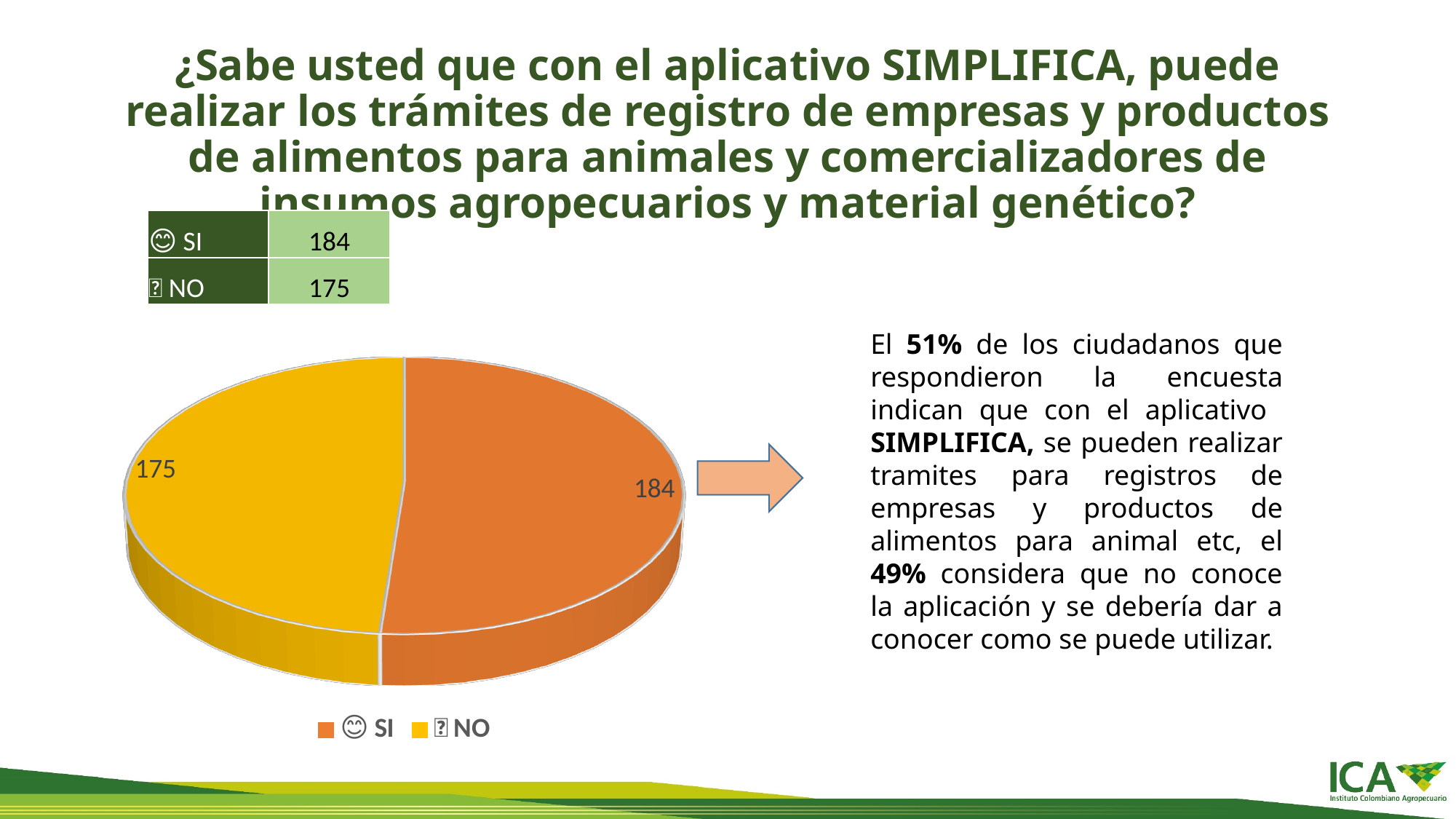
How many slices does the pie chart have? 2 What is the total of all slices in the pie chart? 359 What is the difference between the SI and NO values in the pie chart? 9 Which is larger in the pie chart, SI or NO? SI What share of the pie does the SI slice represent? 51% Which category has the smallest slice in the pie chart? NO What colour is the NO slice in the pie chart? yellow What is the value for NO in the pie chart? 175 Which category has the largest slice in the pie chart? SI What kind of chart is shown on the slide? pie chart How many entries does the pie chart legend list? 2 What is the value for SI in the pie chart? 184